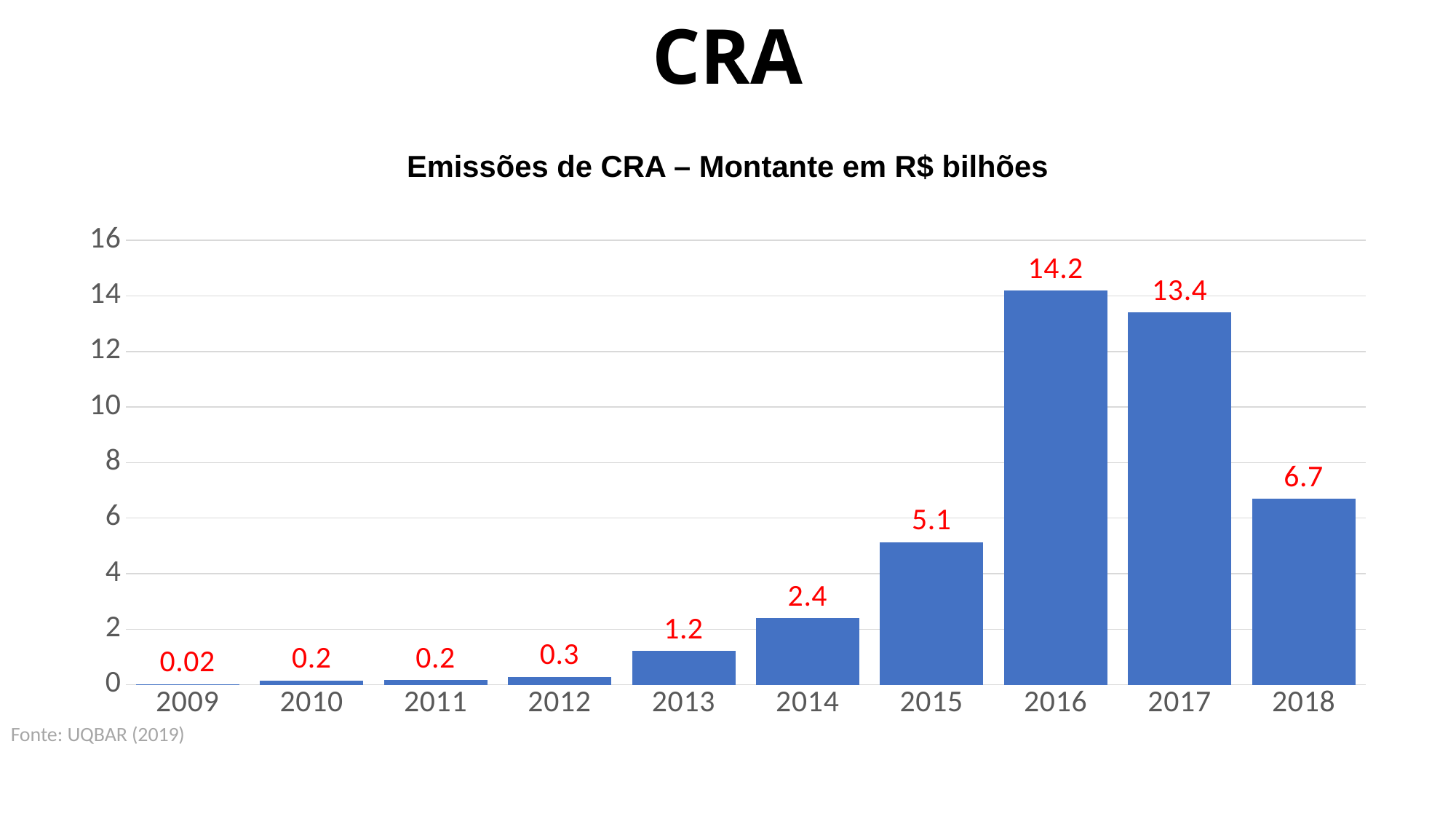
What is the value for 2016? 14.2 Which year has the lowest value? 2009 What is the title of the chart? Emissões de CRA – Montante em R$ bilhões Which is larger, the value for 2015 or the value for 2018? 2018 What kind of chart is shown on the slide? bar chart How many years are shown on the x axis? 10 Is the value for 2015 greater or less than 4? greater What is the difference between the values for 2017 and 2018? 6.7 What is the value for 2009? 0.02 Which year has the highest value? 2016 What is the value for 2018? 6.7 What is the difference between the values for 2016 and 2017? 0.8